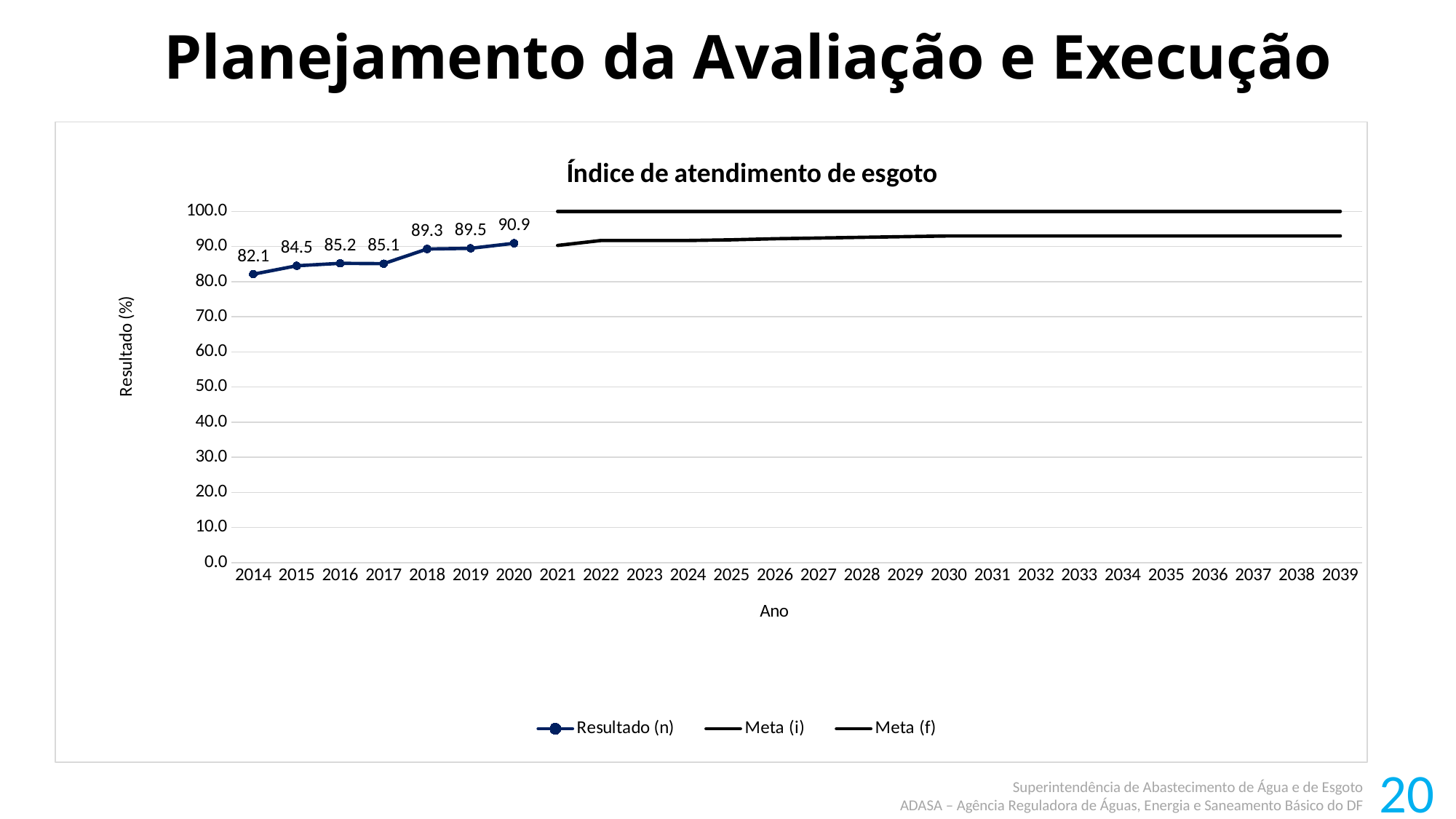
Does the Resultado (n) series generally rise or fall from 2014 to 2020? rise What type of chart is shown on the slide? line chart In which year is the Resultado (n) value highest? 2020 How many series does the legend list? 3 What is the value of Resultado (n) for 2014? 82.1 What is the difference between the Resultado (n) values for 2020 and 2014? 8.8 Which is larger, the Resultado (n) value for 2016 or for 2017? 2016 What is the value of Resultado (n) for 2020? 90.9 In which year is the Resultado (n) value lowest? 2014 What is the value of Resultado (n) for 2018? 89.3 What is the title of the chart? Índice de atendimento de esgoto Is the value of Meta (f) for 2030 greater or less than 80.0? greater